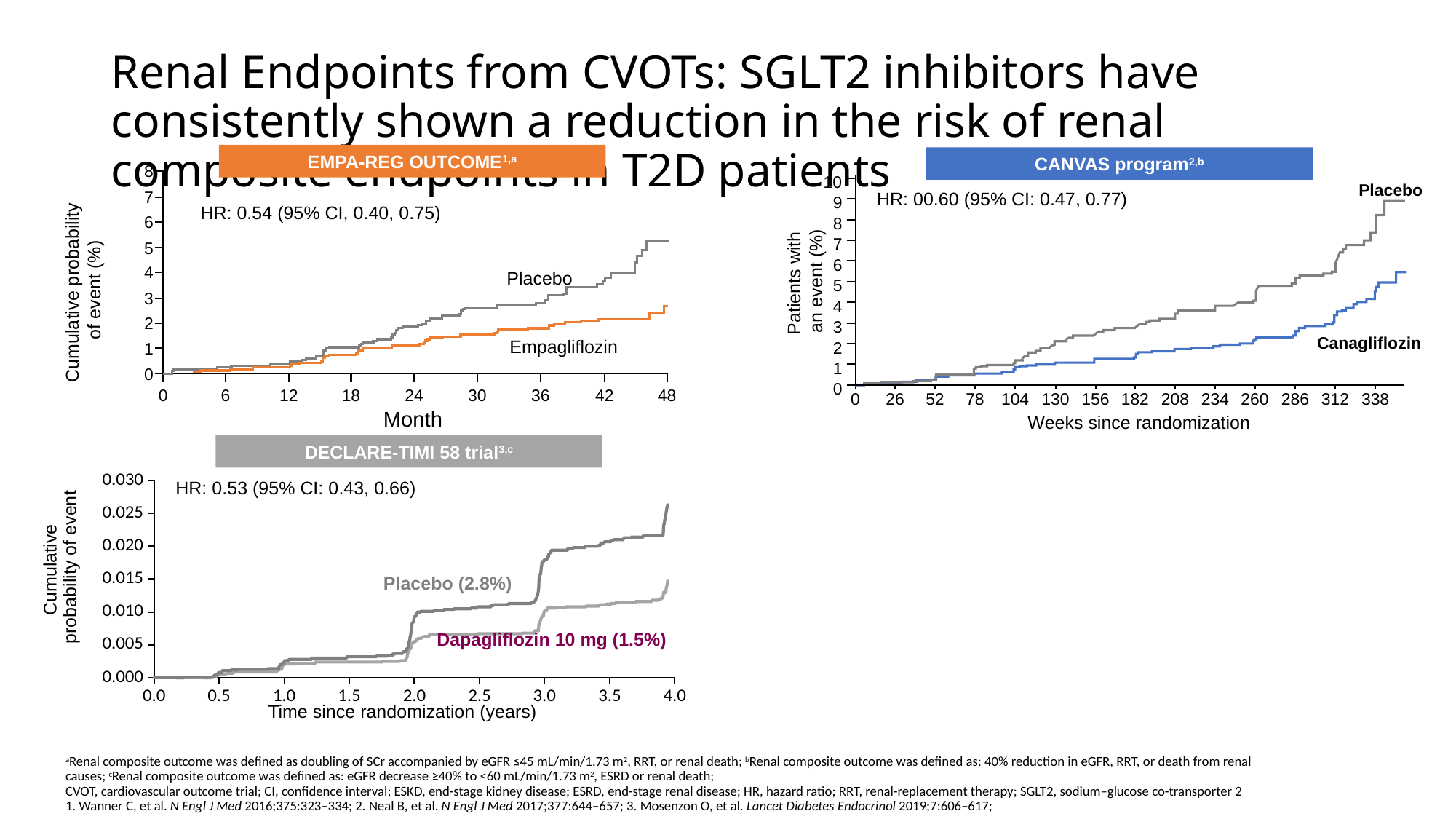
In the DECLARE-TIMI 58 trial chart, what percentage is shown in the label for Placebo? 2.8% How many series are plotted in the EMPA-REG OUTCOME chart? 2 In the EMPA-REG OUTCOME chart, is the Placebo value at month 48 greater or less than 4? greater In the DECLARE-TIMI 58 trial chart, does the Placebo curve rise or fall over time since randomization? rise In the EMPA-REG OUTCOME chart, which series is higher at month 48, Placebo or Empagliflozin? Placebo In the CANVAS program chart, which series is higher at the end of follow-up, Placebo or Canagliflozin? Placebo In the EMPA-REG OUTCOME chart, is the Empagliflozin value at month 48 greater or less than 4? less In the CANVAS program chart, is the Placebo value at the end of follow-up greater or less than 8? greater What is the x-axis label of the CANVAS program chart? Weeks since randomization What kind of chart is the EMPA-REG OUTCOME chart? line chart In the DECLARE-TIMI 58 trial chart, what is the difference between the labelled percentages for Placebo and Dapagliflozin 10 mg? 1.3%